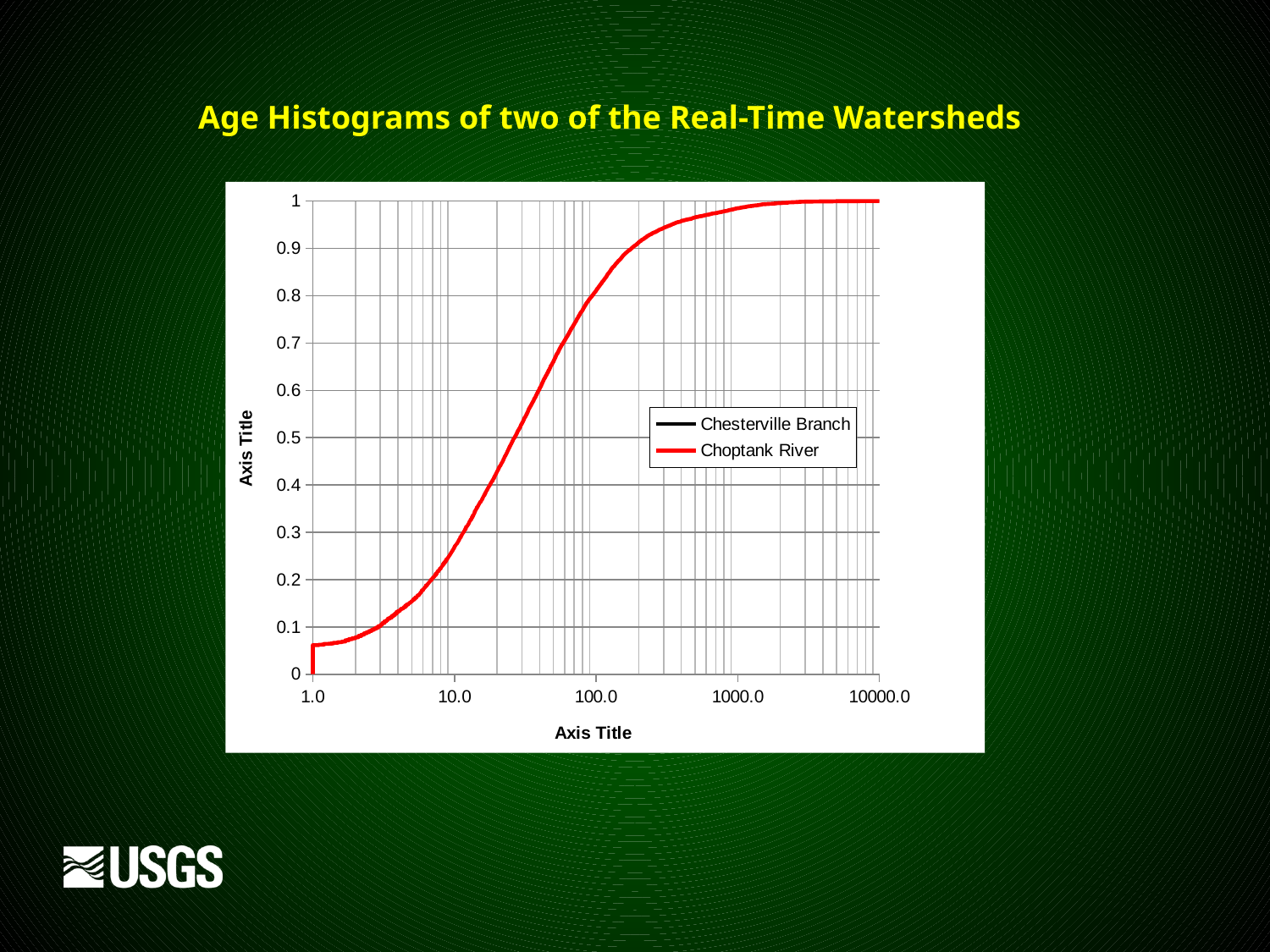
What is the largest value labeled on the x-axis? 10000.0 Is the Choptank River value at x = 100.0 greater or less than 0.7? greater What kind of chart is shown on the slide? line chart What is the highest value labeled on the y-axis? 1 Which two series are named in the legend? Chesterville Branch and Choptank River Is the Choptank River value at x = 10.0 greater or less than 0.4? less How many labeled tick marks are shown on the x-axis? 5 What is the title of the chart on the slide? Age Histograms of two of the Real-Time Watersheds Is the Choptank River value at x = 1.0 greater or less than 0.1? less Does the Choptank River line rise or fall as the x-axis value increases? rise How many series does the legend list? 2